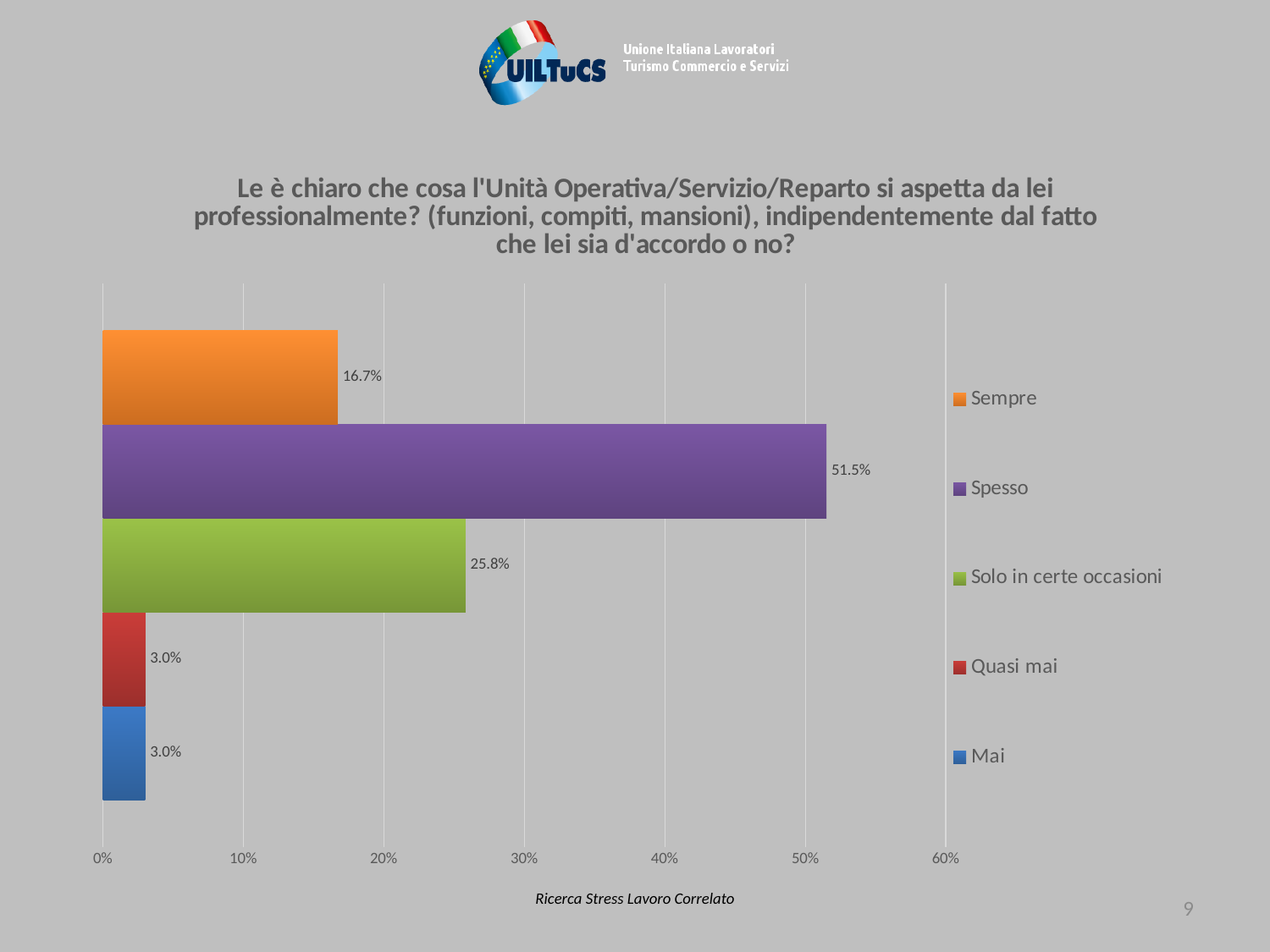
What colour is the bar for Mai? blue How many categories does the legend list? 5 Which category has the highest value? Spesso Which is larger, the value for Sempre or the value for Solo in certe occasioni? Solo in certe occasioni What is the difference between the values for Solo in certe occasioni and Sempre? 9.1% What is the value for Quasi mai? 3.0% What is the value for Sempre? 16.7% What is the difference between the values for Spesso and Solo in certe occasioni? 25.7% What is the value for Spesso? 51.5% Is the value for Spesso greater or less than 50%? greater What kind of chart is shown on the slide? bar chart What is the value for Solo in certe occasioni? 25.8%